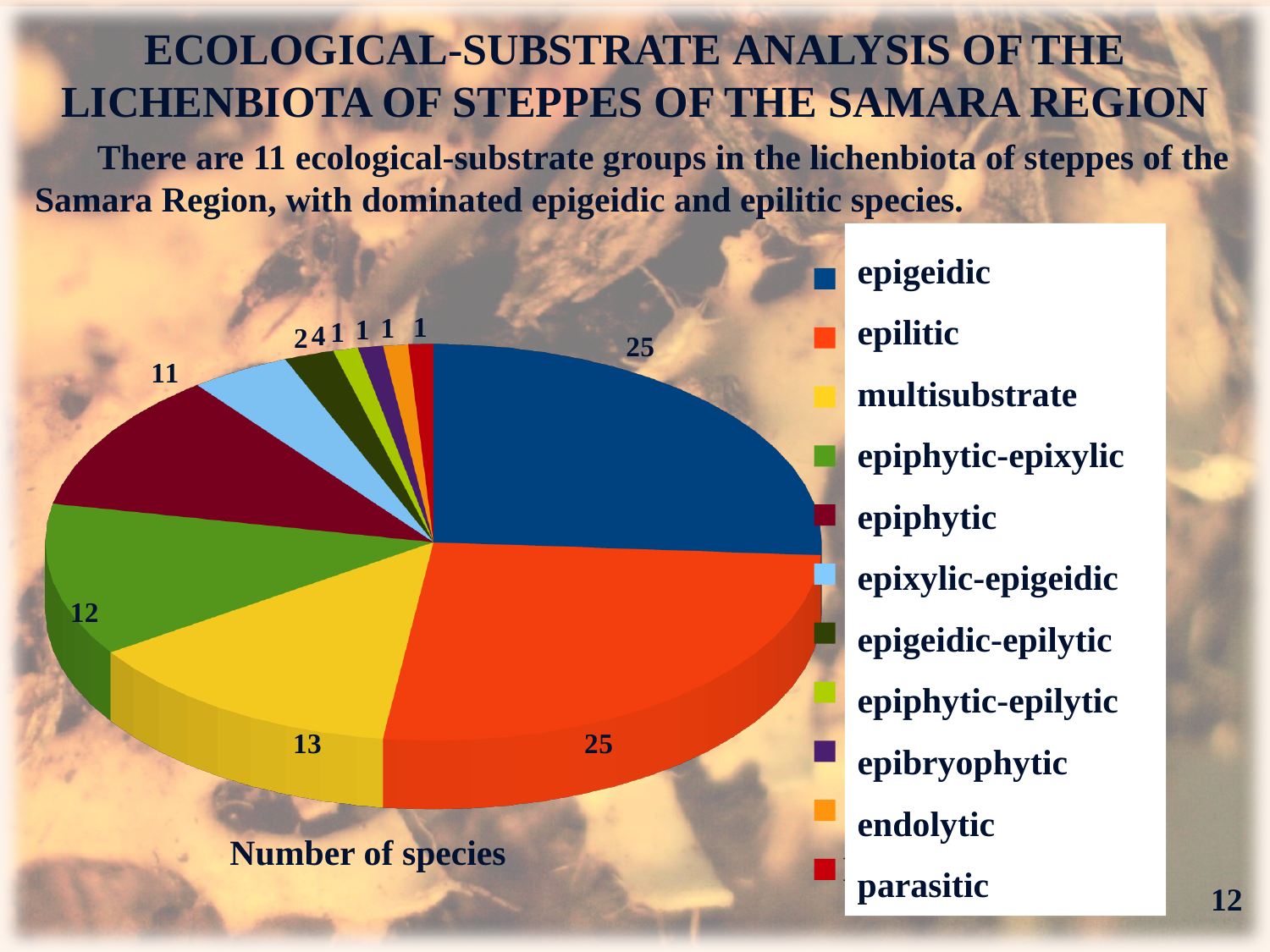
How many entries does the legend list? 11 How many species are in the epigeidic group? 25 What is the value for the epiphytic-epixylic slice? 12 What kind of chart is shown on the slide? pie chart What is the value for the parasitic slice? 1 Which two groups share the largest value in the pie chart? epigeidic and epilitic How many slices does the pie chart have? 11 What is the value for the multisubstrate slice? 13 What is the value for the epiphytic slice? 11 What label appears below the pie chart? Number of species Which is larger, the multisubstrate slice or the epiphytic-epixylic slice? multisubstrate What is the difference between the epilitic value and the multisubstrate value? 12